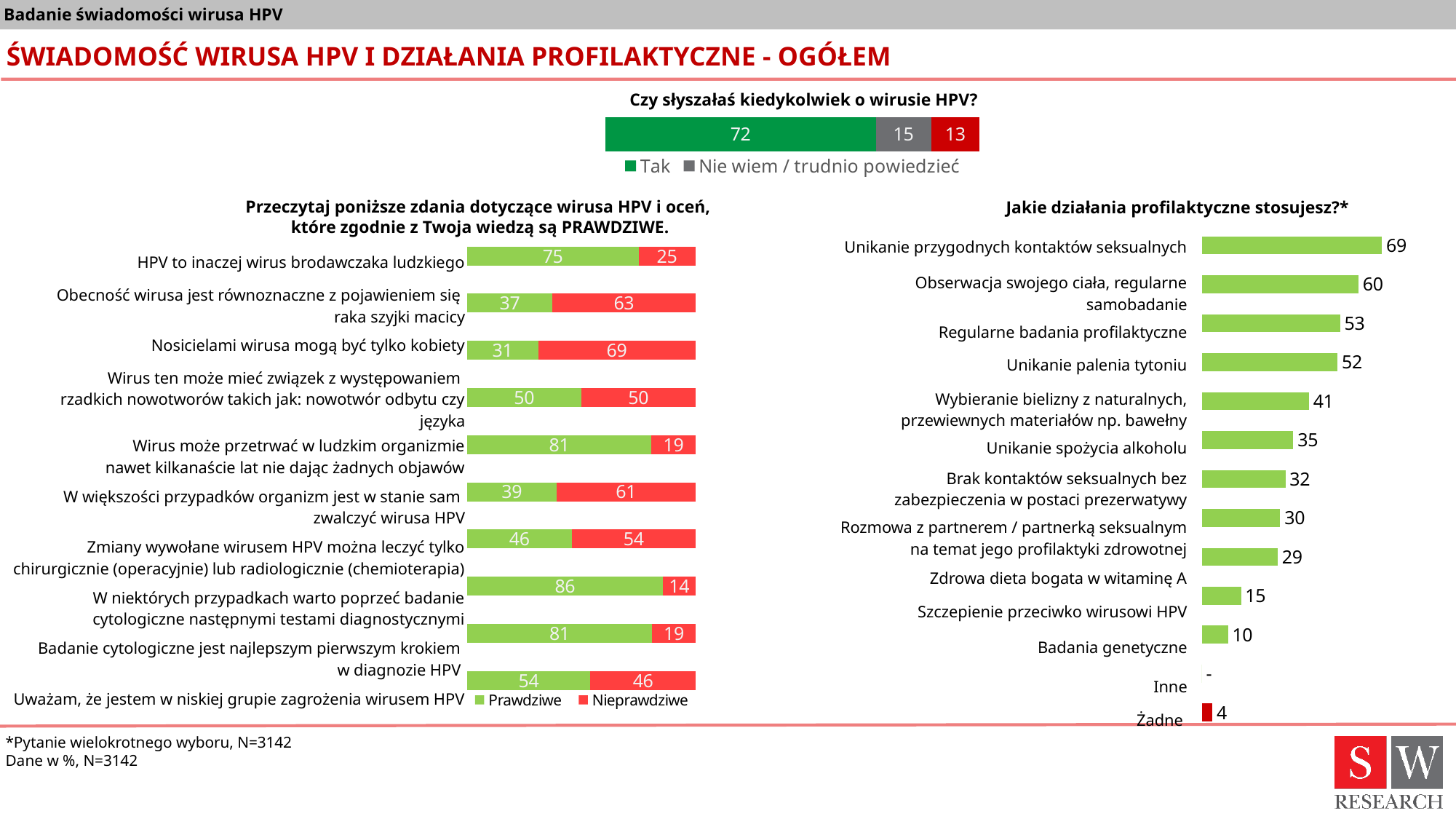
In the chart 'Przeczytaj poniższe zdania dotyczące wirusa HPV...', how many series does the legend list? 2 In the chart 'Jakie działania profilaktyczne stosujesz?', what is the value for 'Unikanie palenia tytoniu'? 52 In the chart 'Czy słyszałaś kiedykolwiek o wirusie HPV?', what is the value for 'Nie wiem / trudno powiedzieć'? 15 In the chart 'Jakie działania profilaktyczne stosujesz?', what is the difference between 'Unikanie przygodnych kontaktów seksualnych' and 'Obserwacja swojego ciała, regularne samobadanie'? 9 In the chart 'Czy słyszałaś kiedykolwiek o wirusie HPV?', what is the value for 'Tak'? 72 In the chart 'Jakie działania profilaktyczne stosujesz?', which is larger: 'Unikanie spożycia alkoholu' or 'Szczepienie przeciwko wirusowi HPV'? Unikanie spożycia alkoholu In the chart 'Jakie działania profilaktyczne stosujesz?', what is the value for 'Żadne'? 4 In the chart 'Przeczytaj poniższe zdania dotyczące wirusa HPV...', how many statements are plotted? 10 What type of chart is 'Jakie działania profilaktyczne stosujesz?'? Bar chart In the chart 'Przeczytaj poniższe zdania dotyczące wirusa HPV...', what is the 'Nieprawdziwe' value for 'Nosicielami wirusa mogą być tylko kobiety'? 69 In the chart 'Przeczytaj poniższe zdania dotyczące wirusa HPV...', what is the 'Prawdziwe' value for 'HPV to inaczej wirus brodawczaka ludzkiego'? 75 In the chart 'Jakie działania profilaktyczne stosujesz?', which category has the highest value? Unikanie przygodnych kontaktów seksualnych